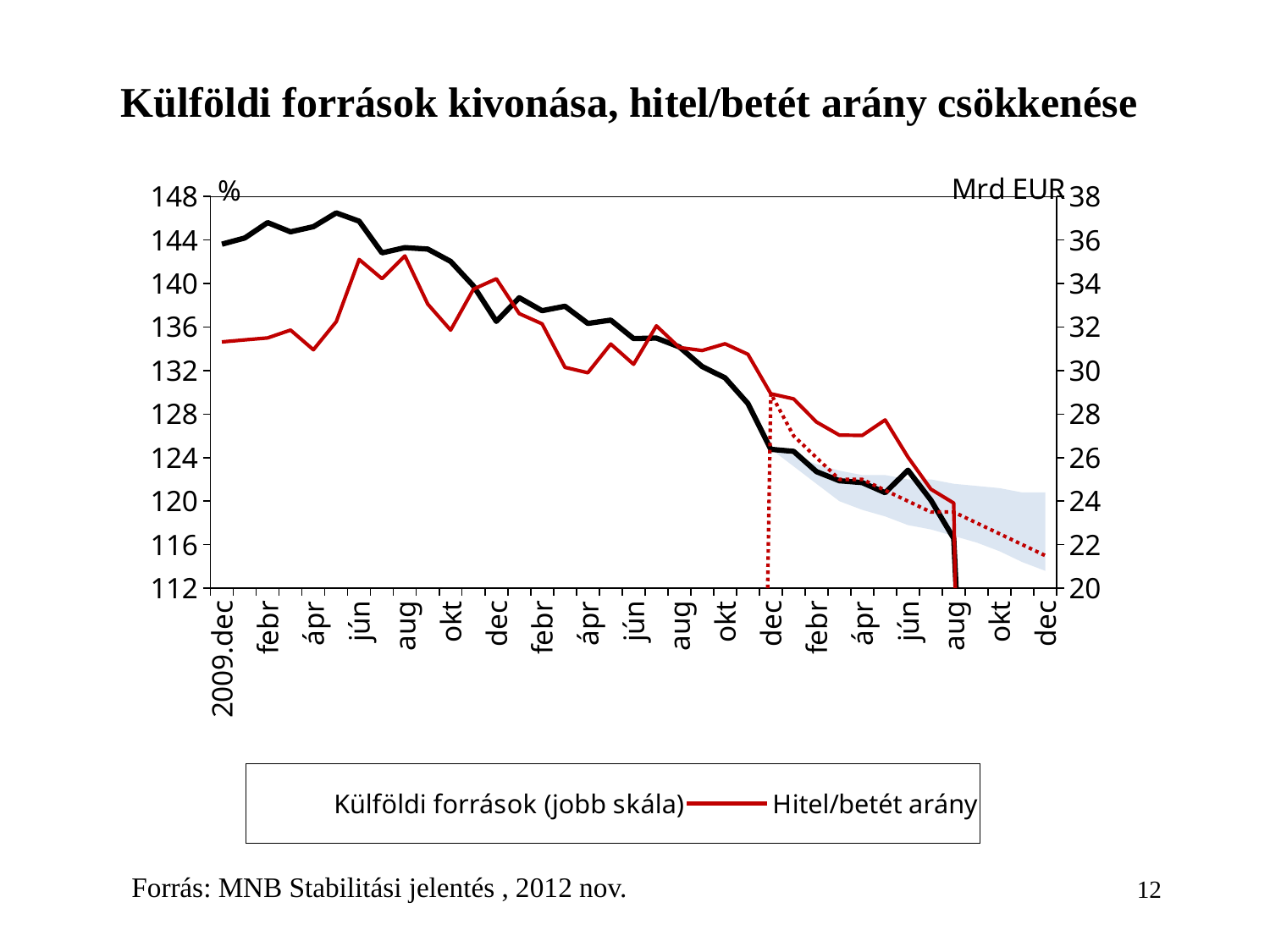
Is the Hitel/betét arány value at 2009.dec greater or less than 132? greater What unit is shown on the right-hand axis? Mrd EUR Is the Külföldi források value at 2009.dec greater or less than 34 Mrd EUR? greater How many series does the legend list? 2 What kind of chart is shown on the slide? line chart Is the Hitel/betét arány value at aug 2010 greater or less than 140? greater What is the title of the slide's chart? Külföldi források kivonása, hitel/betét arány csökkenése Which series is plotted on the right-hand scale according to the legend? Külföldi források (jobb skála) Does the Hitel/betét arány series rise or fall overall from 2009.dec to the end of the chart? fall Does the Külföldi források series rise or fall overall from 2009.dec to aug 2012? fall